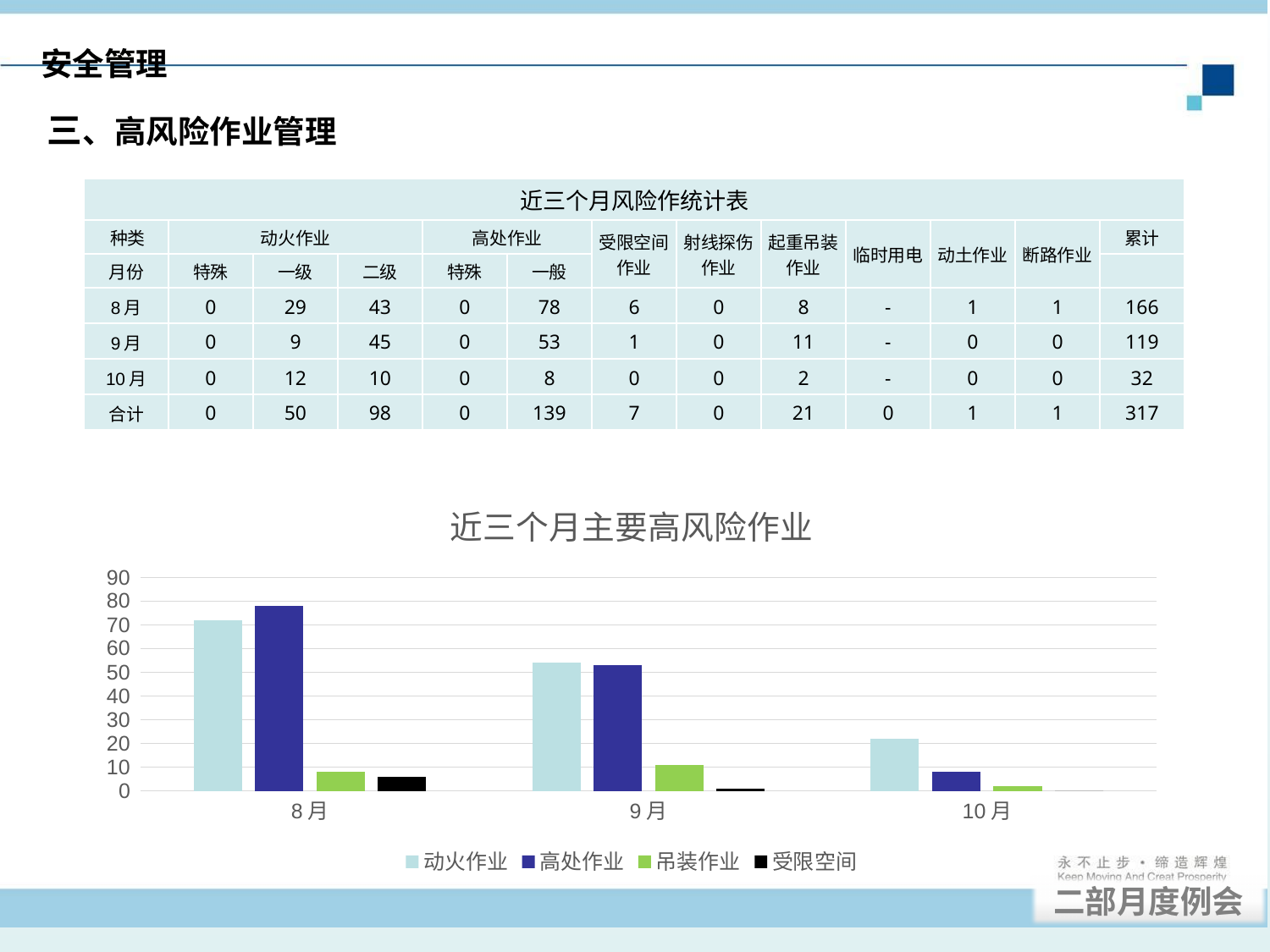
What kind of chart is shown on the slide? bar chart What is the title of the chart? 近三个月主要高风险作业 Is the value for 吊装作业 in 9月 greater or less than 20? less Which series has the tallest bar in 8月? 高处作业 Which is larger, 动火作业 in 8月 or 动火作业 in 9月? 动火作业 in 8月 Which series has the shortest bar in 9月? 受限空间 Which series has the tallest bar in 10月? 动火作业 Is the value for 高处作业 in 8月 greater or less than 70? greater How many month categories are shown on the x axis of the chart? 3 How many series does the chart legend list? 4 Is the value for 动火作业 in 10月 greater or less than 30? less Does the 高处作业 series rise or fall from 8月 to 10月? fall